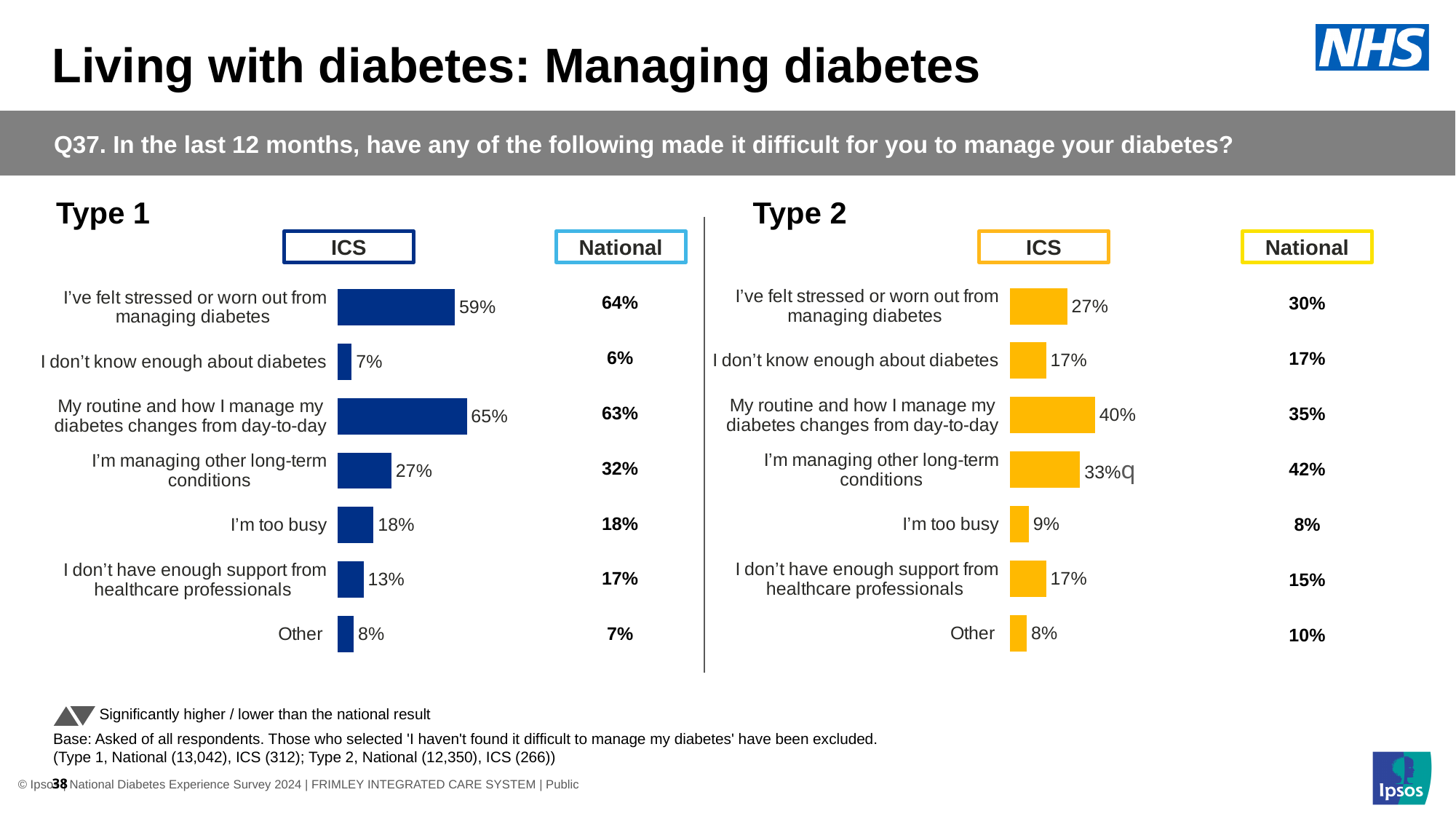
In the Type 1 chart, what is the ICS value for 'I'm too busy'? 18% In the Type 1 chart, what is the ICS value for 'I've felt stressed or worn out from managing diabetes'? 59% In the Type 2 chart, which is larger for 'I'm managing other long-term conditions': the ICS value or the National value? National In the Type 1 chart, what is the National value for 'I'm managing other long-term conditions'? 32% In the Type 2 chart, what is the ICS value for 'My routine and how I manage my diabetes changes from day-to-day'? 40% In the Type 2 chart, which category has the lowest ICS value? Other In the Type 1 chart, what is the difference between the ICS and National values for 'I've felt stressed or worn out from managing diabetes'? 5 percentage points In the Type 2 chart, what is the National value for 'Other'? 10% What colour are the ICS bars in the Type 2 chart? Yellow How many categories are shown in the Type 1 chart? 7 In the Type 1 chart, which category has the highest ICS value? My routine and how I manage my diabetes changes from day-to-day What type of chart is used to show the ICS values in the Type 2 chart? Bar chart